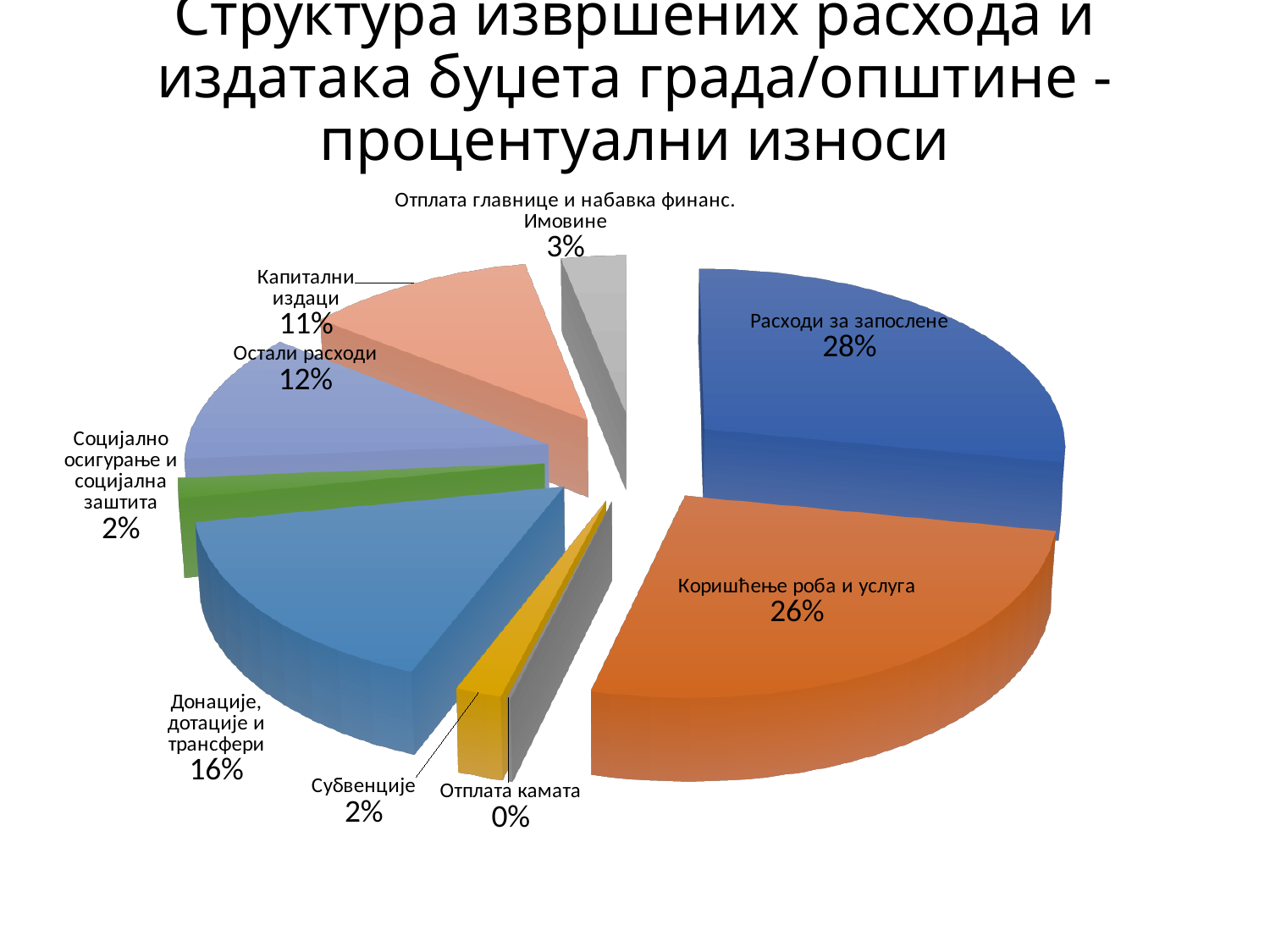
What percentage is shown for Отплата камата? 0% What share of the pie is labelled for Расходи за запослене? 28% What kind of chart is shown on the slide? Pie chart What is the difference in percentage points between Расходи за запослене and Коришћење роба и услуга? 2 percentage points Which category has the smallest share of the pie? Отплата камата What is the combined share of Субвенције and Социјално осигурање и социјална заштита? 4% What percentage is shown for Донације, дотације и трансфери? 16% What percentage is shown for Коришћење роба и услуга? 26% How many categories (slices) does the pie chart have? 9 What percentage is shown for Капитални издаци? 11% Which category has the largest share of the pie? Расходи за запослене Which is larger, the share for Остали расходи or the share for Капитални издаци? Остали расходи